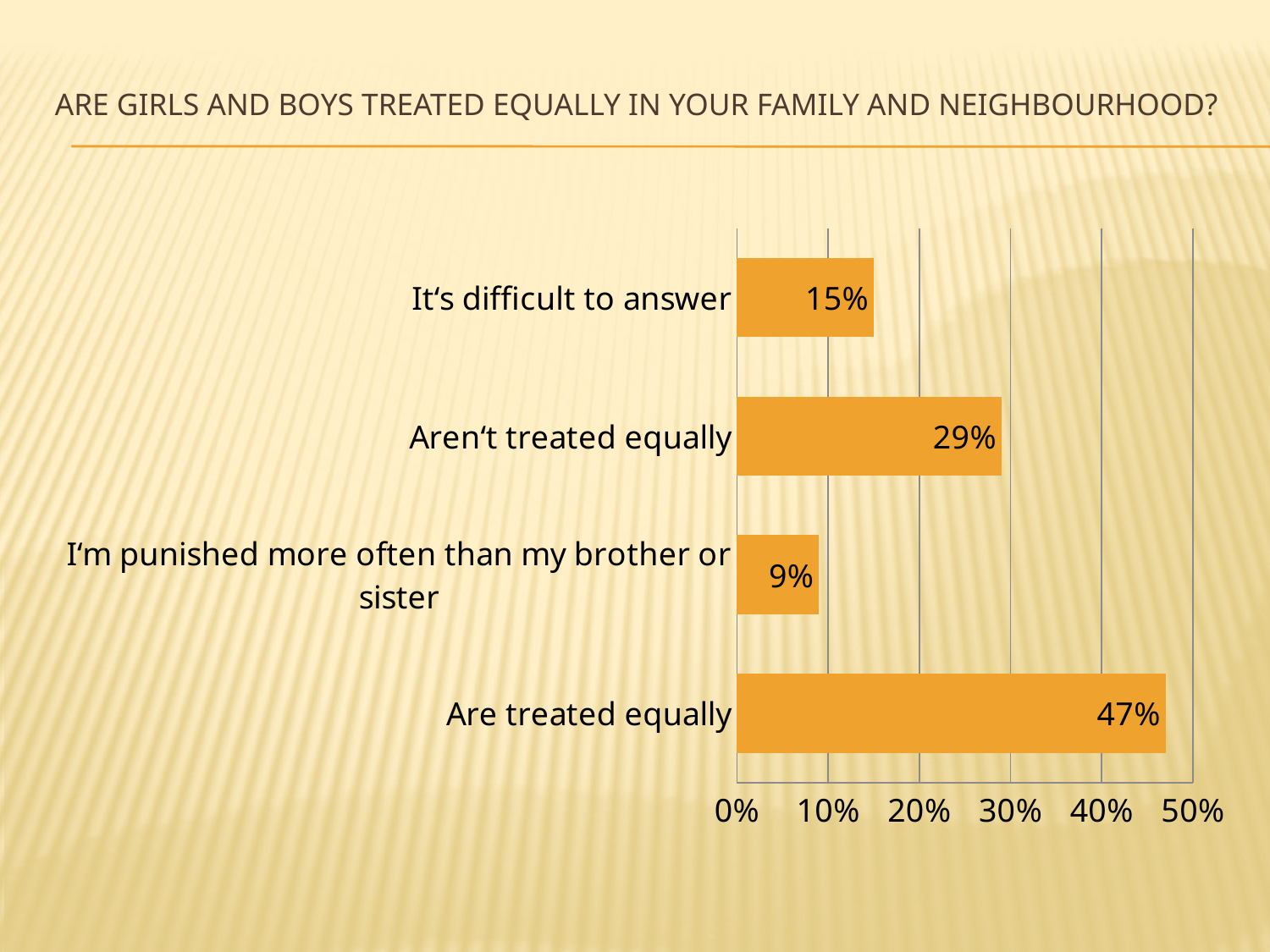
How many response categories are shown in the chart? 4 What is the difference in percentage points between 'Are treated equally' and 'Aren't treated equally'? 18% What percentage of respondents said it's difficult to answer? 15% What is the maximum value shown on the horizontal axis? 50% What is the difference in percentage points between 'It's difficult to answer' and 'I'm punished more often than my brother or sister'? 6% Which is larger: the percentage for 'Aren't treated equally' or for 'It's difficult to answer'? Aren't treated equally What percentage of respondents said girls and boys aren't treated equally? 29% Which response has the highest percentage? Are treated equally What percentage of respondents said girls and boys are treated equally? 47% What type of chart is shown on the slide? Bar chart Which response has the lowest percentage? I'm punished more often than my brother or sister What percentage of respondents said they are punished more often than their brother or sister? 9%